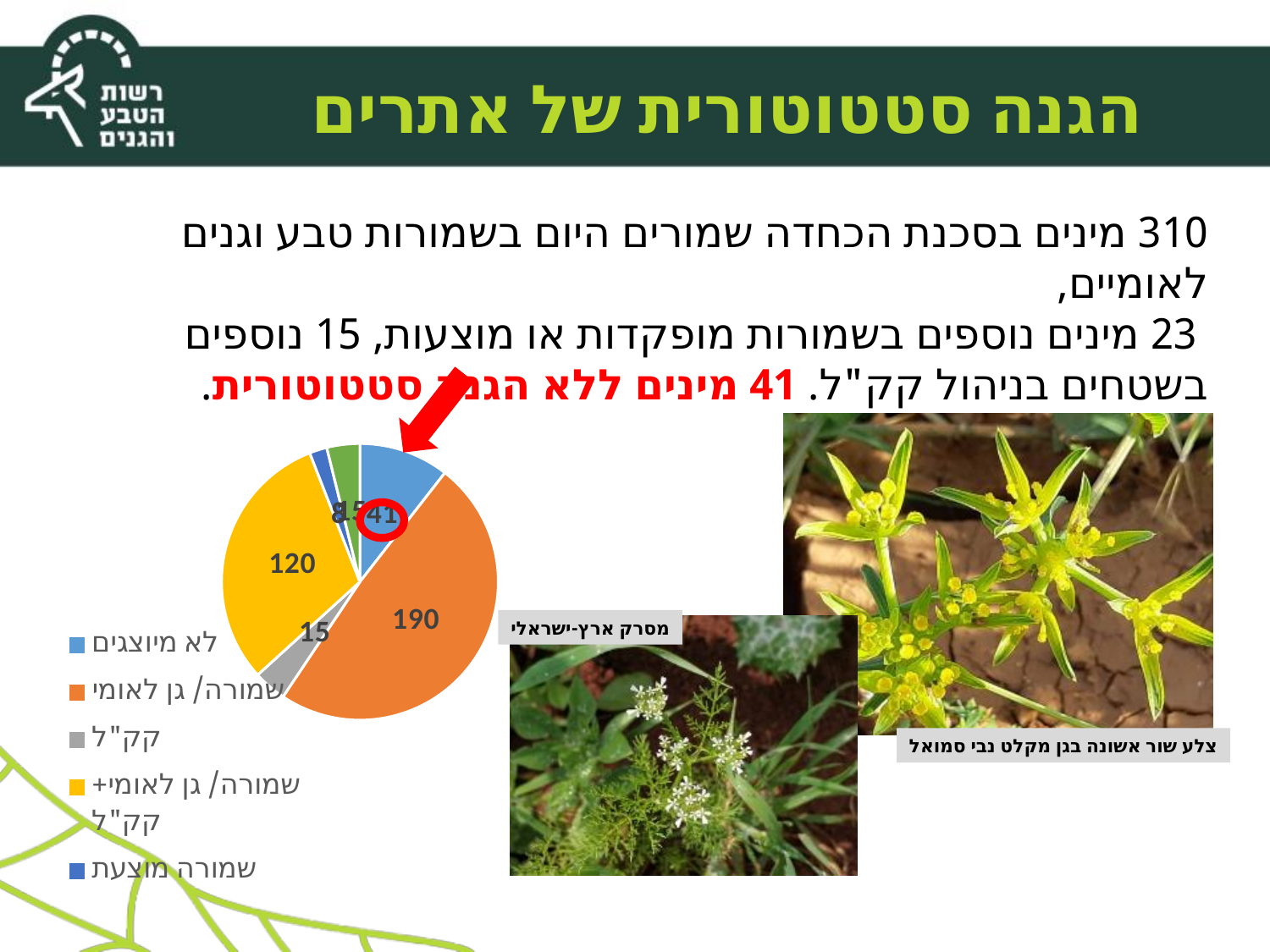
What value is shown for the slice labelled שמורה/ גן לאומי+ קק"ל in the pie chart? 120 What is the difference between the values for שמורה/ גן לאומי+ קק"ל and לא מיוצגים in the pie chart? 79 What kind of chart is shown on the slide? pie chart What is the difference between the values for שמורה/ גן לאומי and שמורה/ גן לאומי+ קק"ל in the pie chart? 70 What colour is the largest slice of the pie chart? orange How many entries does the legend of the pie chart list? 5 What is the difference between the values for לא מיוצגים and קק"ל in the pie chart? 26 Which is larger in the pie chart: שמורה/ גן לאומי or שמורה/ גן לאומי+ קק"ל? שמורה/ גן לאומי What value is shown for the slice labelled קק"ל in the pie chart? 15 Which category has the largest slice in the pie chart? שמורה/ גן לאומי What value is shown for the slice labelled שמורה/ גן לאומי in the pie chart? 190 What value is shown for the slice labelled לא מיוצגים in the pie chart? 41